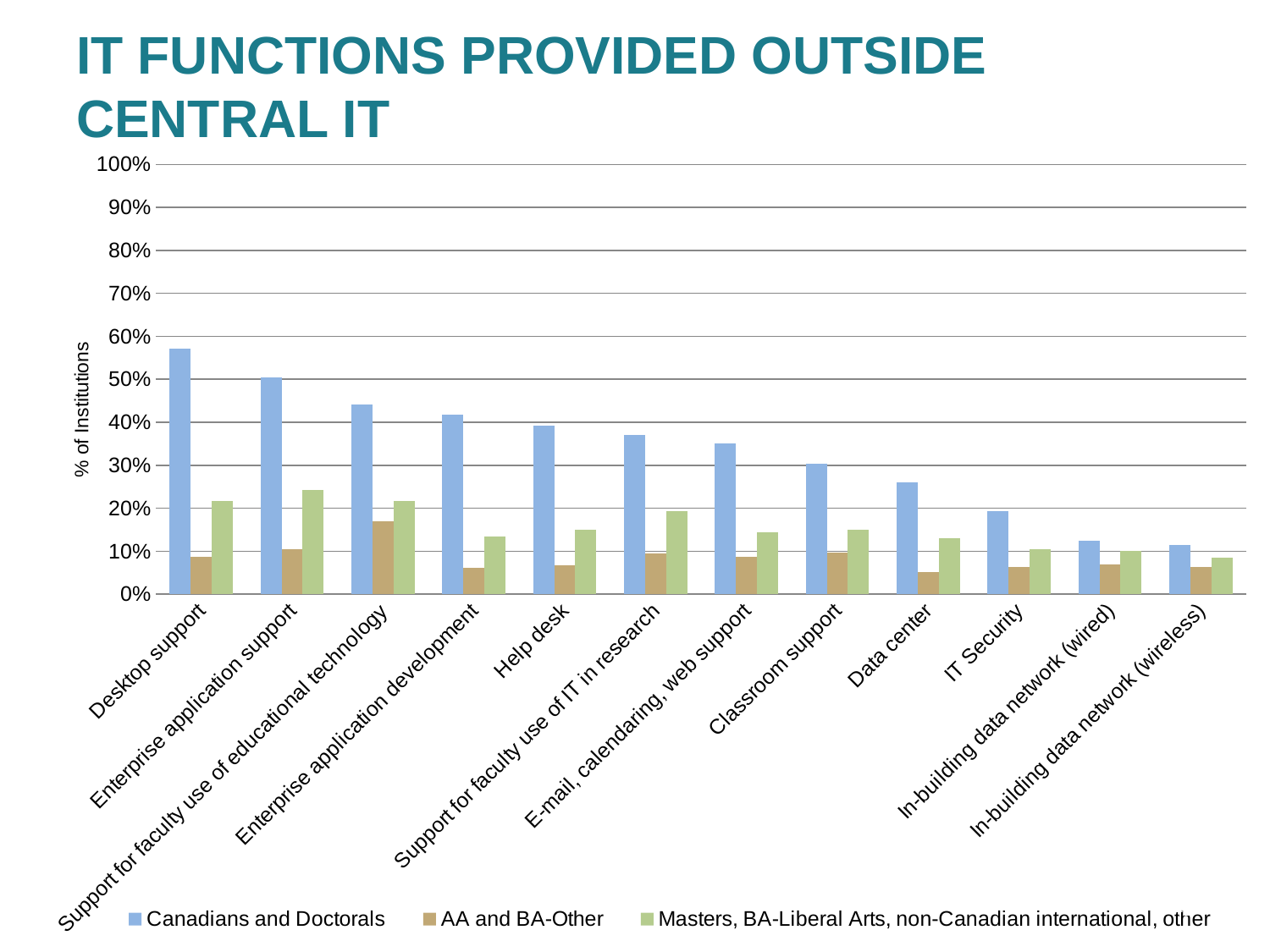
Is the Canadians and Doctorals value for Data center greater or less than 30%? less What kind of chart is shown on the slide? bar chart Which category has the highest value for the AA and BA-Other series? Support for faculty use of educational technology For Desktop support, which series has the larger value: Canadians and Doctorals or AA and BA-Other? Canadians and Doctorals What is the label on the y axis? % of Institutions Is the Canadians and Doctorals value for Desktop support greater or less than 50%? greater Is the AA and BA-Other value for Support for faculty use of educational technology greater or less than 10%? greater Which category has the highest value for the Canadians and Doctorals series? Desktop support How many IT function categories are shown on the x axis? 12 How many series does the legend list? 3 Do the Canadians and Doctorals values rise or fall moving from left to right along the x axis? fall